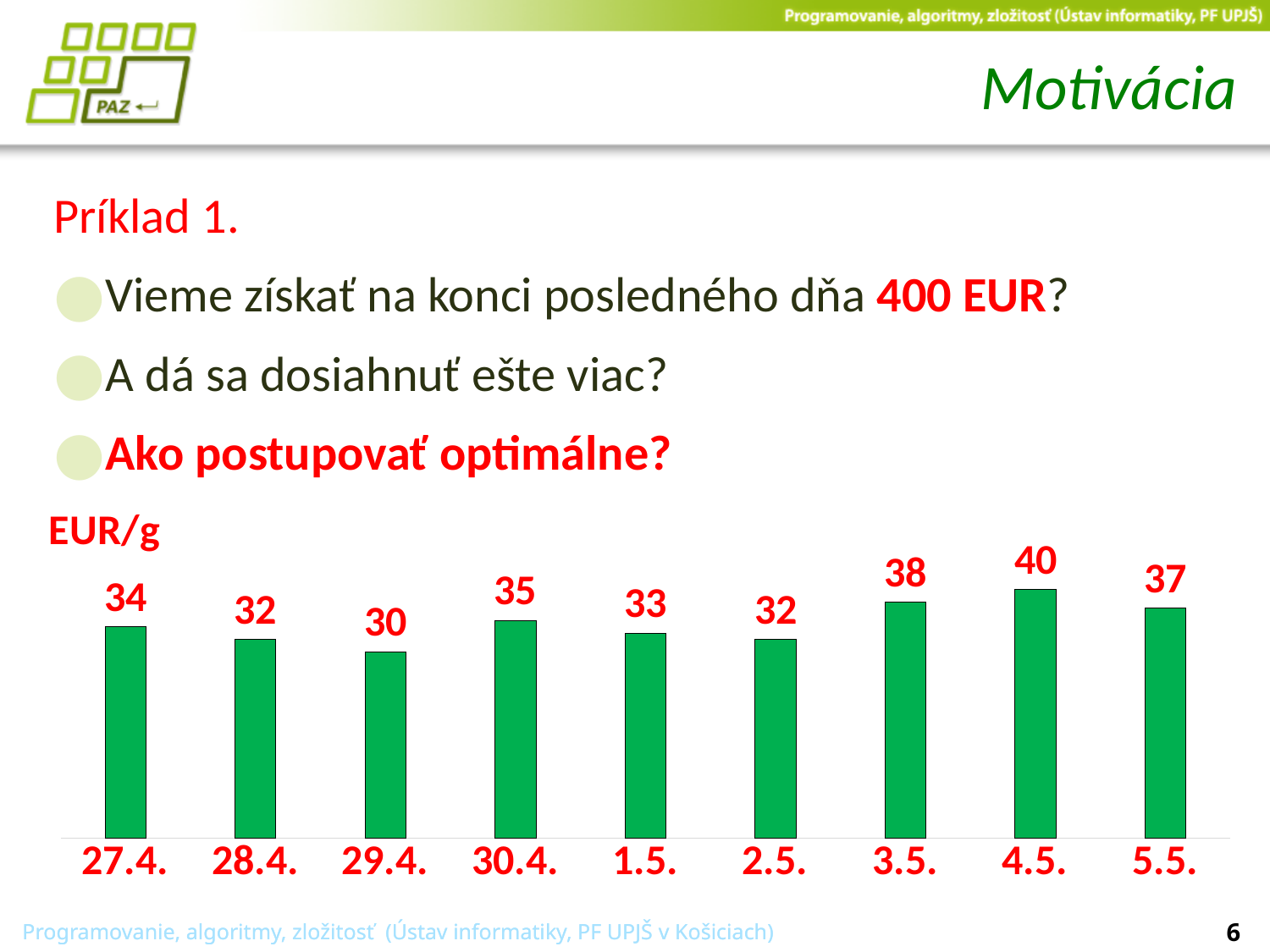
Which is larger, the value for 5.5. or the value for 3.5.? 3.5. What is the difference between the values for 30.4. and 1.5.? 2 What is the value for 27.4.? 34 Do the values rise or fall from 1.5. to 4.5.? rise What kind of chart is shown? bar chart What is the value for 29.4.? 30 What is the difference between the values for 4.5. and 29.4.? 10 What is the value for 3.5.? 38 What unit label is shown above the chart? EUR/g Which date has the lowest value? 29.4. How many dates are shown on the x axis? 9 Which date has the highest value? 4.5.